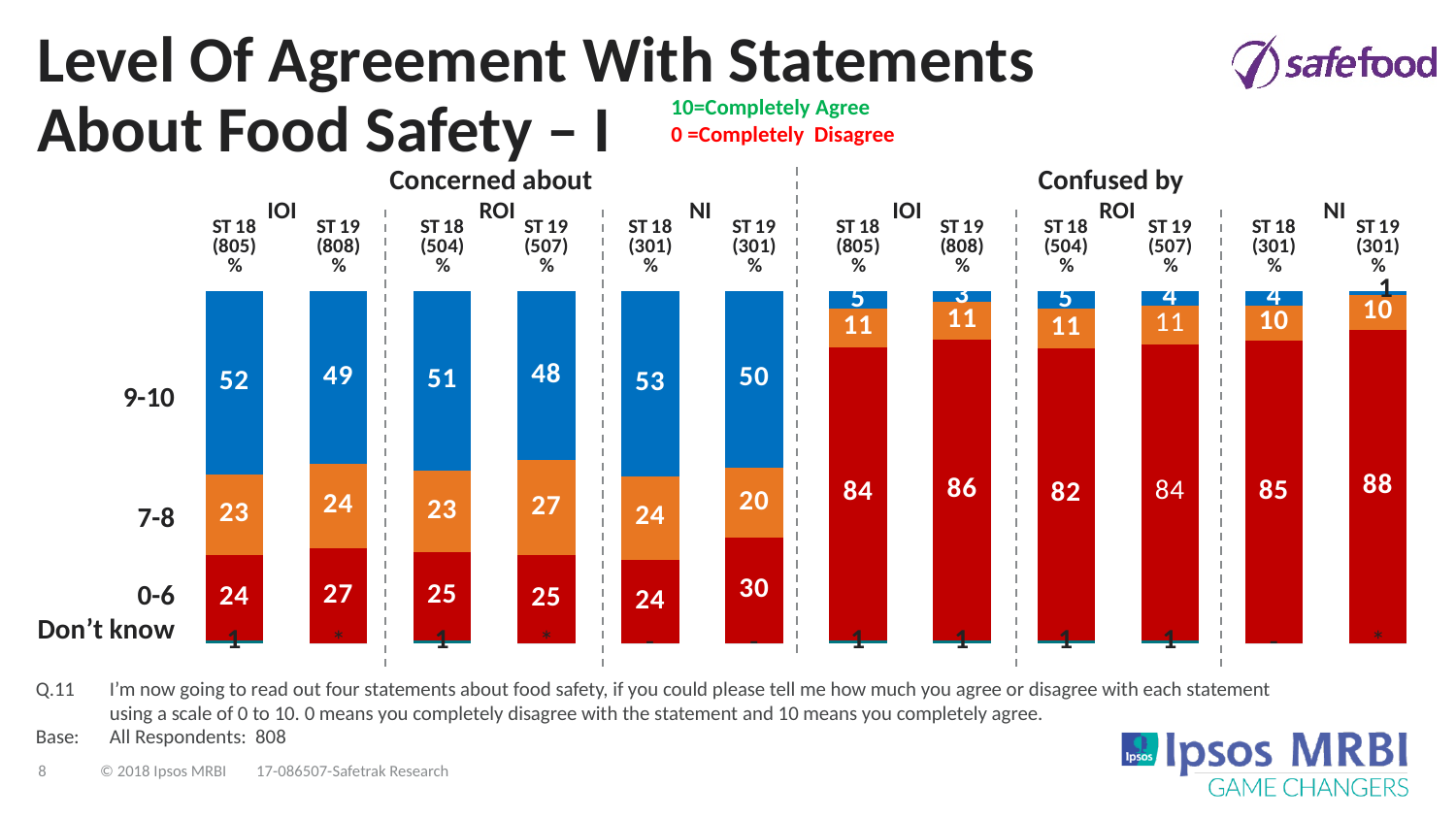
In the 'Concerned about' chart, which bar has the highest 0-6 value? NI ST 19 In the 'Confused by' chart, which bar has the lowest 0-6 value? ROI ST 18 How many bars are shown in the 'Concerned about' chart? 6 In the 'Concerned about' chart, what is the 7-8 value for ROI ST 19? 27 In the 'Concerned about' chart, what is the 9-10 value for NI ST 18? 53 In the 'Concerned about' chart, what is the difference between the 9-10 values for IOI ST 18 and IOI ST 19? 3 In the 'Confused by' chart, what is the 0-6 value for NI ST 19? 88 In the 'Concerned about' chart, what is the combined 7-8 and 9-10 value for NI ST 19? 70 In the 'Confused by' chart, what is the 9-10 value for IOI ST 19? 3 What type of chart is used on this slide? Stacked bar chart In the 'Confused by' chart, which is larger: the 0-6 value for IOI ST 19 or for ROI ST 19? IOI ST 19 Which colour represents the 0-6 category in the charts? Red